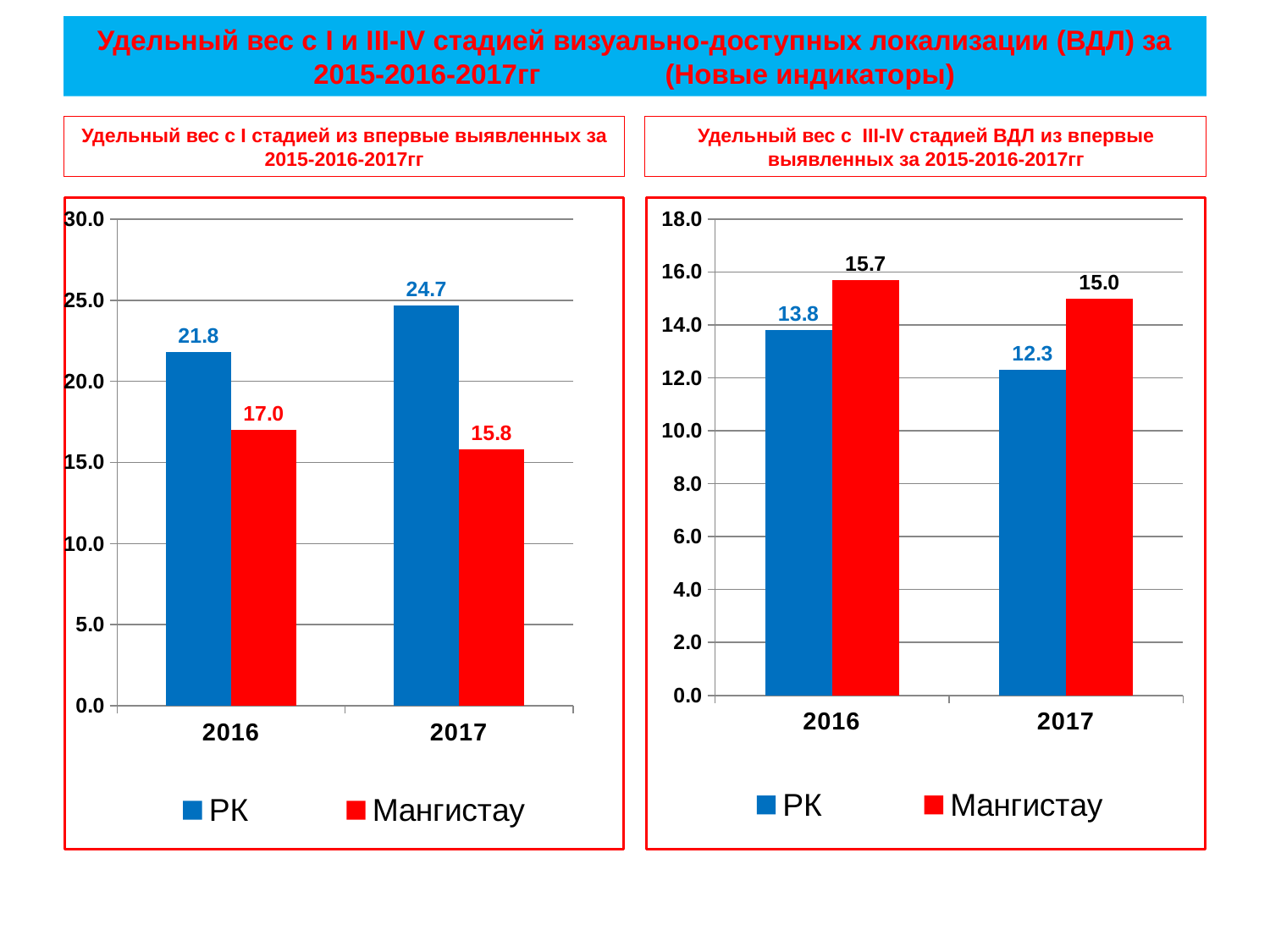
In the left chart (stage I), which bar is the highest? РК in 2017 In the right chart (stage III-IV), what is the difference between Мангистау and РК in 2016? 1.9 In the right chart (stage III-IV), which series has the higher value in 2017, РК or Мангистау? Мангистау In the right chart (stage III-IV), which bar is the lowest? РК in 2017 In the left chart (stage I), what is the value for РК in 2017? 24.7 In the left chart (stage I), what is the value for Мангистау in 2016? 17.0 In the right chart (stage III-IV), what is the value for Мангистау in 2017? 15.0 What kind of chart is the left chart? bar chart In the left chart (stage I), what is the difference between РК and Мангистау in 2017? 8.9 How many series does the legend of the right chart list? 2 In the left chart (stage I), does the value for Мангистау rise or fall from 2016 to 2017? fall In the right chart (stage III-IV), what is the value for РК in 2016? 13.8